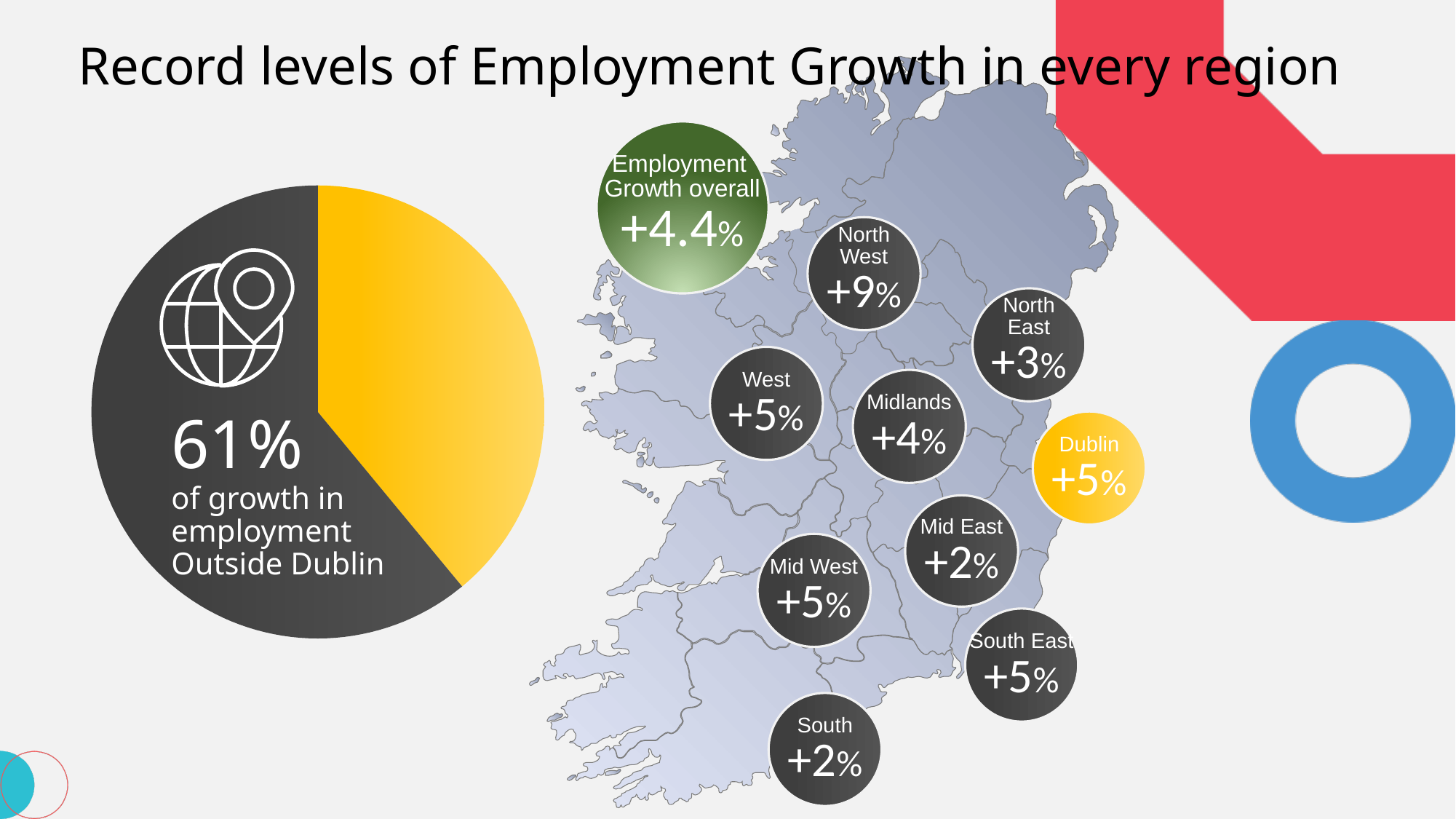
How many slices does the pie chart have? 2 On the map, what is the difference in employment growth between the North West and the North East? 6 percentage points What kind of chart is shown on the left of the slide? Pie chart On the map, what is the employment growth figure for the North West region? +9% On the map, which region has the highest employment growth? North West On the map, what is the employment growth figure for Dublin? +5% In the pie chart, what share of growth in employment is Outside Dublin? 61% How many regions are labelled with employment growth figures on the map? 9 On the map, which regions have the lowest employment growth at +2%? Mid East and South What colour is the pie slice labelled 61% of growth in employment Outside Dublin? Dark grey In the pie chart, which slice is larger, the dark grey slice or the yellow slice? The dark grey slice On the map, what is the Employment Growth overall figure? +4.4%